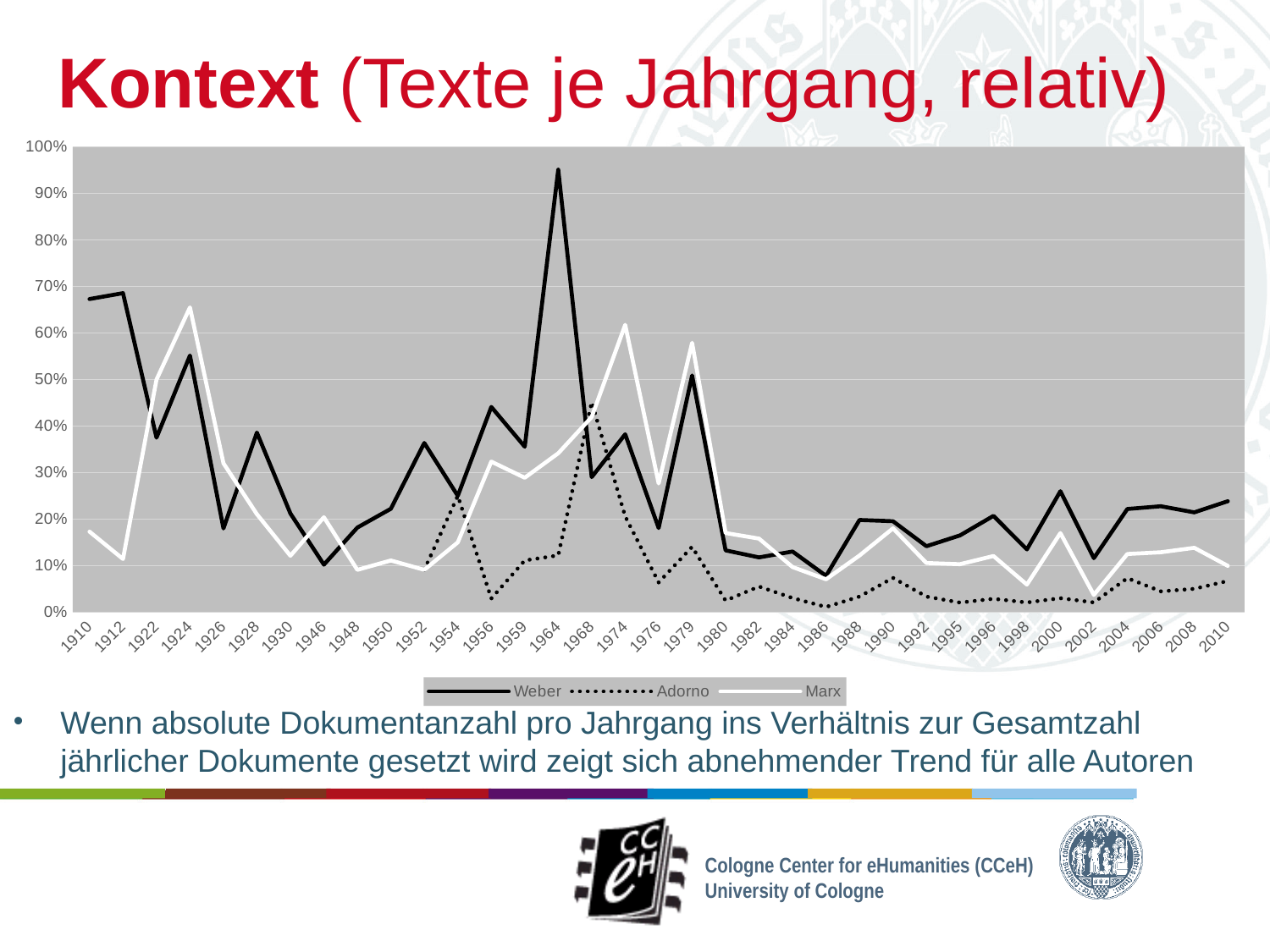
Which series has the higher value in 1974, Weber or Marx? Marx Does the Weber series overall rise or fall from 1910 to 2010? fall Which series reaches the highest value anywhere in the chart? Weber Which series has the higher value in 1910, Weber or Marx? Weber What kind of chart is shown on the slide? line chart Is the value for Weber in 1964 greater or less than 90%? greater Which series are listed in the legend? Weber, Adorno, Marx How many years are shown on the x axis? 35 In which year does the Weber series reach its highest value? 1964 How many series does the legend list? 3 Is the value for Marx in 1924 greater or less than 60%? greater Is the value for Adorno in 1986 greater or less than 10%? less